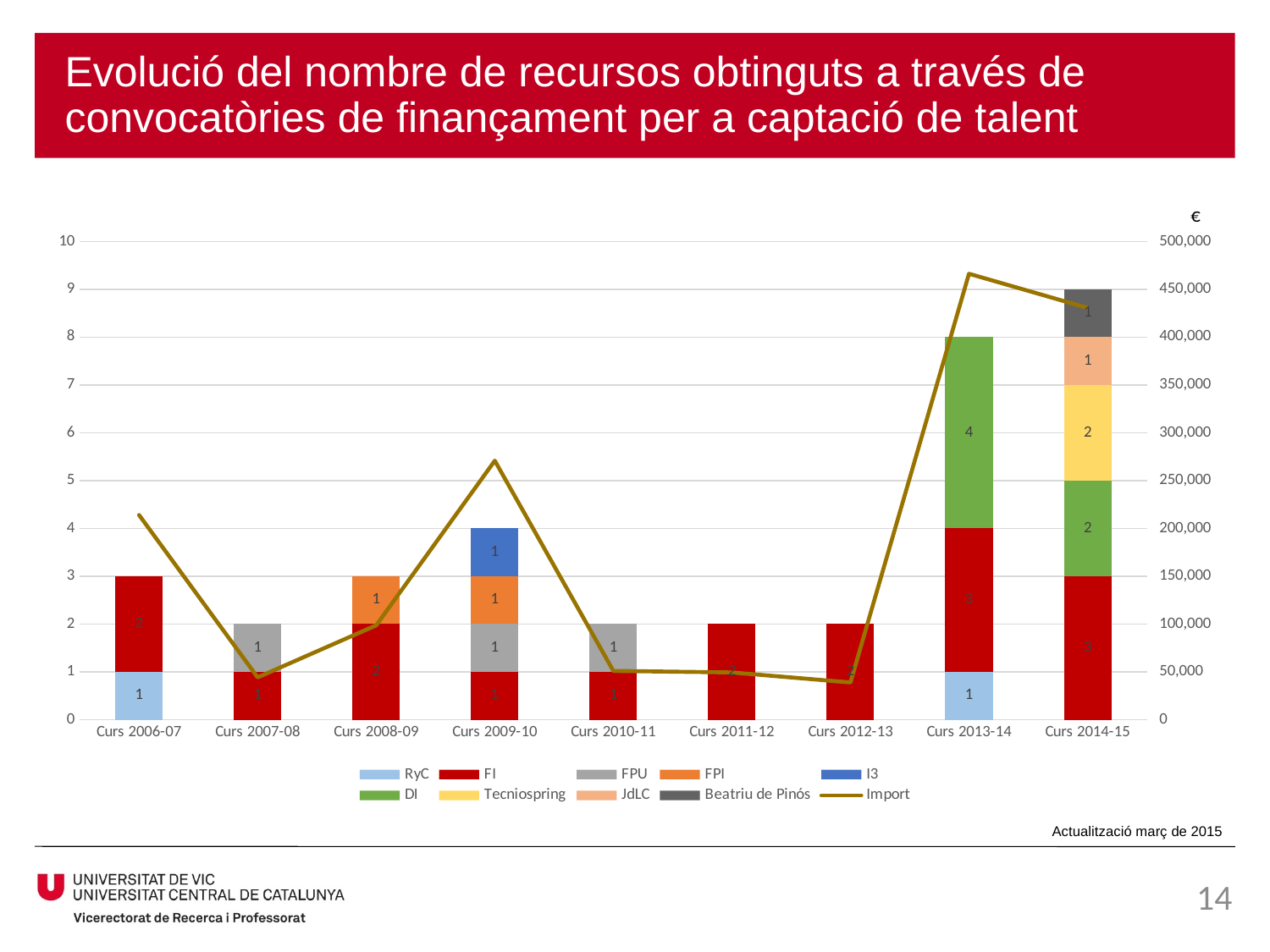
What kind of chart is shown on the slide? bar chart with a line What is the value for DI in Curs 2013-14? 4 Which academic year has the tallest stacked bar? Curs 2014-15 How many academic years (Curs) are shown on the x axis? 9 What is the total height of the stacked bar for Curs 2013-14? 8 What is the value for Tecniospring in Curs 2014-15? 2 Which academic year has the highest Import value on the line? Curs 2013-14 What is the value for I3 in Curs 2009-10? 1 Is the Import value for Curs 2009-10 greater or less than 200,000? greater What is the total height of the stacked bar for Curs 2014-15? 9 Is the Import value for Curs 2013-14 greater or less than 400,000? greater How many series does the legend list? 10